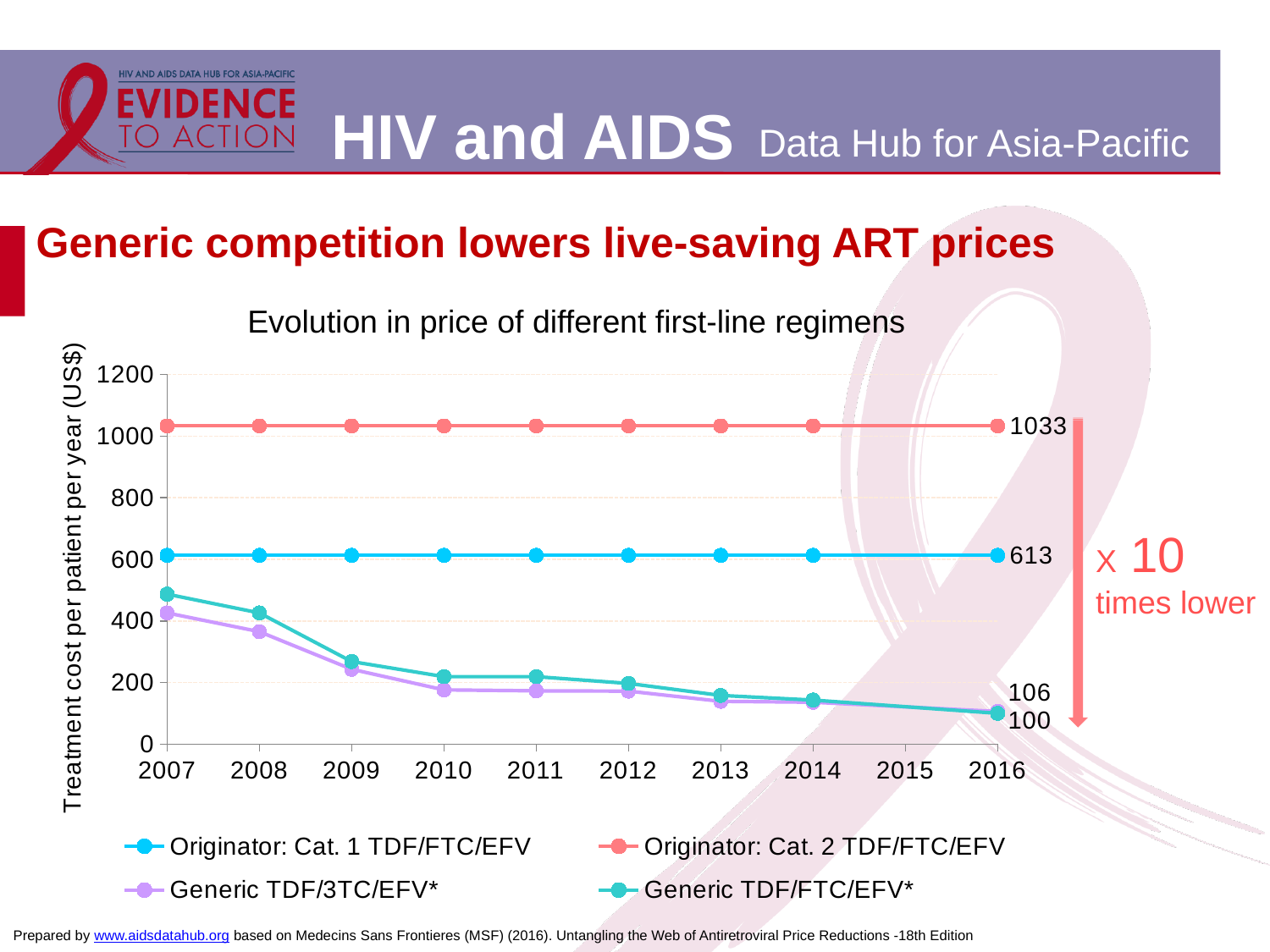
What is the treatment cost per patient per year for Originator: Cat. 2 TDF/FTC/EFV in 2016? 1033 What is the title of the chart? Evolution in price of different first-line regimens What is the difference between the 2016 values of Originator: Cat. 2 TDF/FTC/EFV and Originator: Cat. 1 TDF/FTC/EFV? 420 How many years are shown on the x axis of the chart? 10 What is the difference between the two labelled 2016 values of the generic regimens (106 and 100)? 6 What type of chart is shown on the slide? Line chart Which series has the highest treatment cost in 2016? Originator: Cat. 2 TDF/FTC/EFV Is the value for Generic TDF/3TC/EFV* in 2010 greater or less than 200? less What is the treatment cost per patient per year for Originator: Cat. 1 TDF/FTC/EFV in 2016? 613 How many series does the chart legend list? 4 Do the values for Generic TDF/FTC/EFV* rise or fall from 2007 to 2016? Fall Is the value for Generic TDF/FTC/EFV* in 2007 greater or less than 600? less